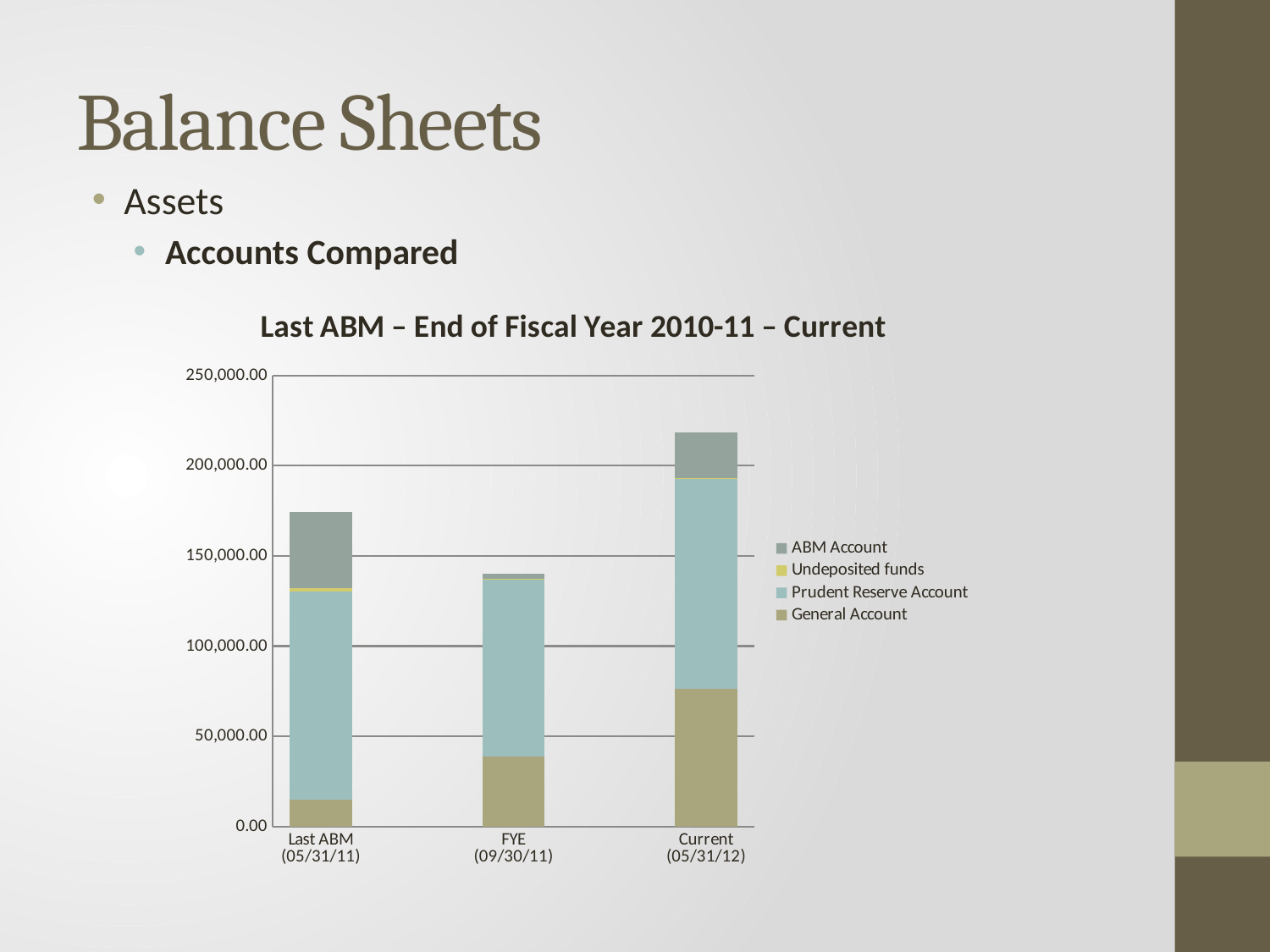
Which is larger, the ABM Account segment for Last ABM (05/31/11) or for FYE (09/30/11)? Last ABM (05/31/11) What kind of chart is shown on the slide? Stacked bar chart Is the General Account value for Current (05/31/12) greater or less than 50,000.00? greater How many series does the chart's legend list? 4 Is the total value for FYE (09/30/11) greater or less than 150,000.00? less Which is larger, the General Account value for Last ABM (05/31/11) or for Current (05/31/12)? Current (05/31/12) How many categories (bars) are shown on the x axis of the chart? 3 Which category has the lowest total bar? FYE (09/30/11) Which category has the highest total bar? Current (05/31/12) Does the General Account value rise or fall from Last ABM (05/31/11) to Current (05/31/12)? rise Is the total value for Current (05/31/12) greater or less than 200,000.00? greater What is the title of the chart? Last ABM – End of Fiscal Year 2010-11 – Current